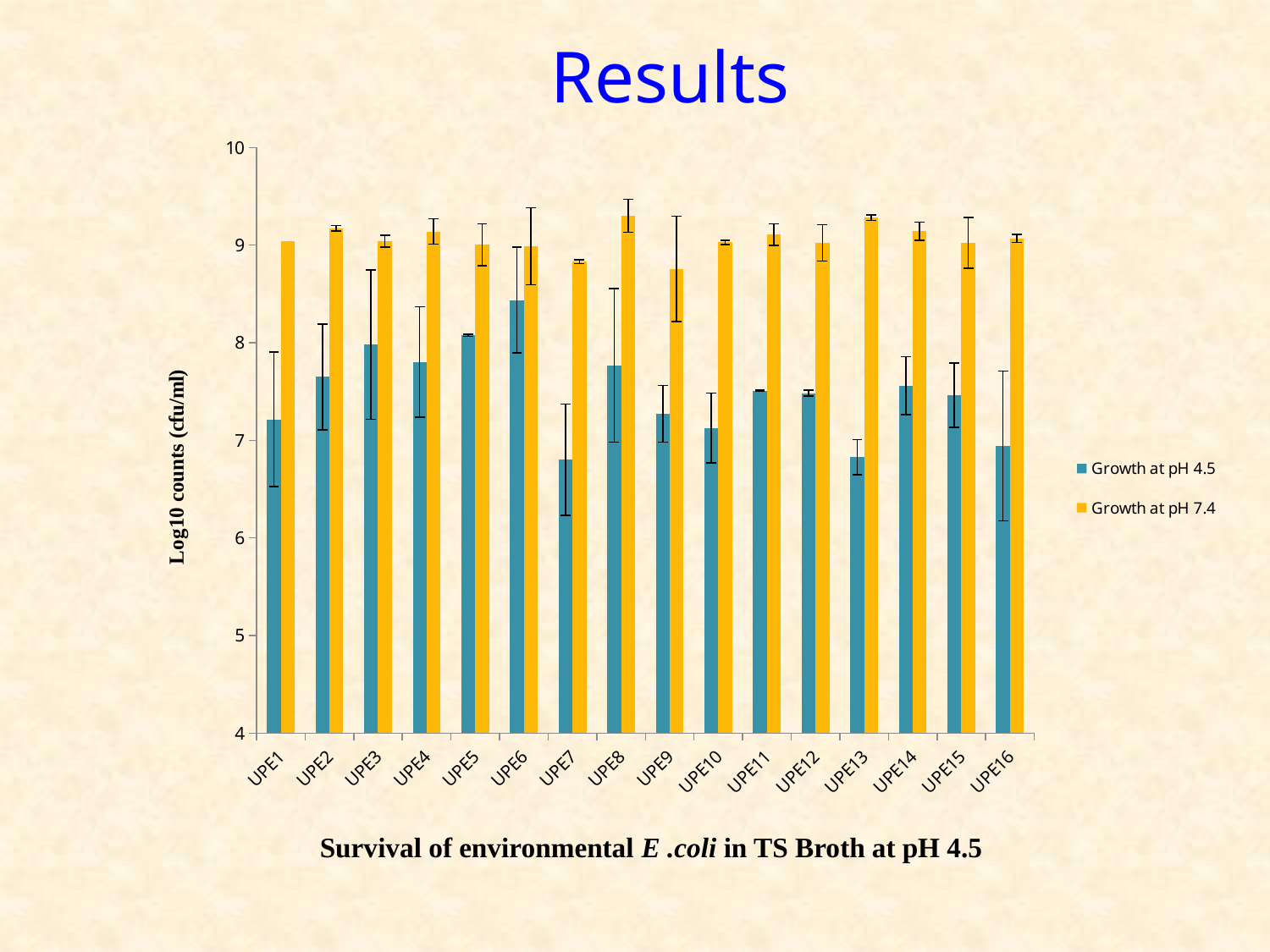
What is the label of the y axis? Log10 counts (cfu/ml) Is the Growth at pH 4.5 value for UPE7 greater or less than 7? less How many isolates (categories) are plotted along the x axis? 16 For UPE1, which is larger: Growth at pH 4.5 or Growth at pH 7.4? Growth at pH 7.4 What kind of chart is shown on the slide? bar chart How many series does the legend list? 2 Which isolate has the highest Growth at pH 4.5 value? UPE6 Is the Growth at pH 4.5 value for UPE6 greater or less than 8? greater Which is larger: the Growth at pH 4.5 value for UPE6 or for UPE7? UPE6 Is the Growth at pH 7.4 value for UPE9 greater or less than 9? less